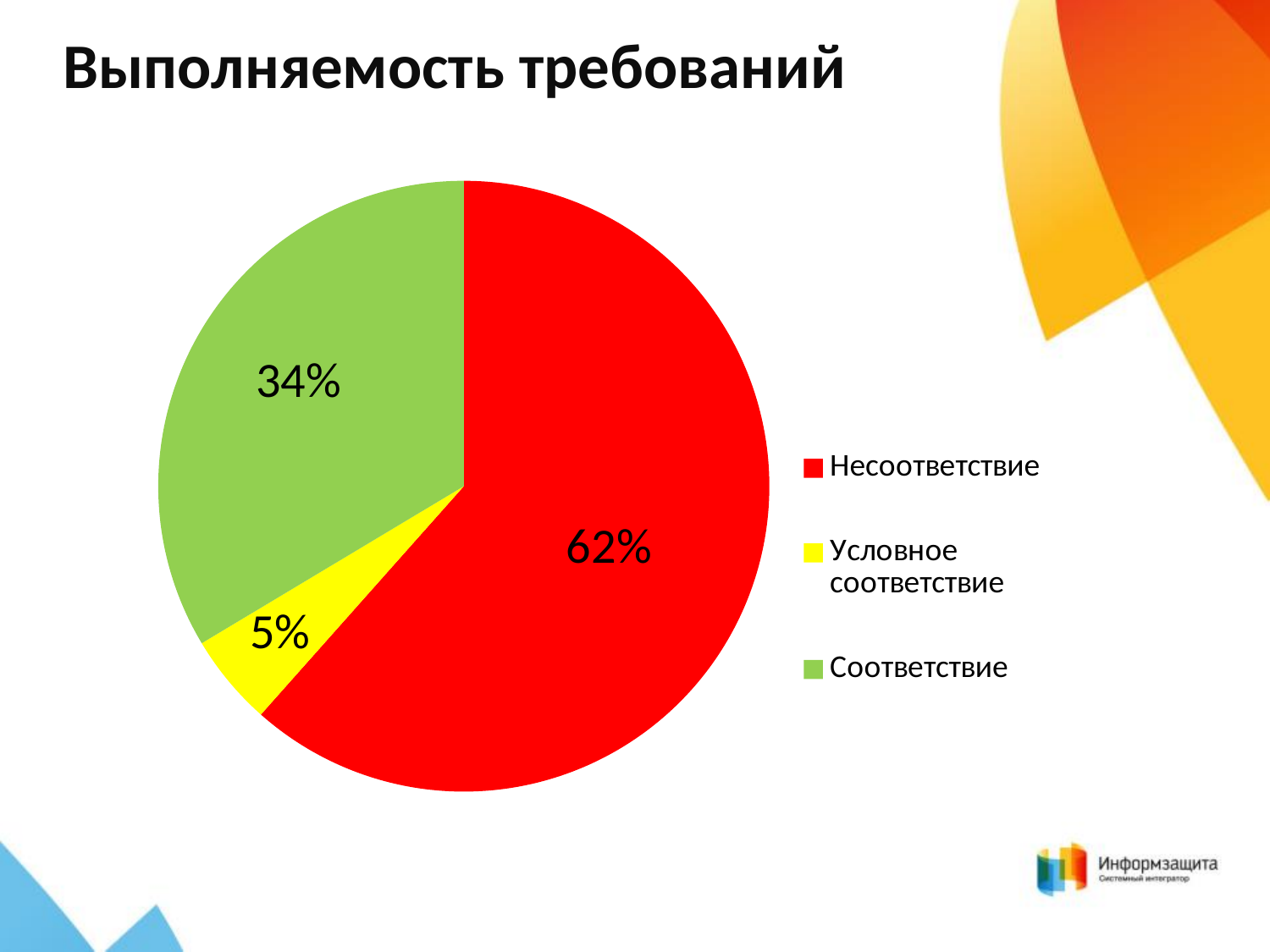
How many entries does the legend list? 3 Which category has the largest slice of the pie? Несоответствие What share of the pie does Несоответствие take? 62% What is the difference in percentage points between Несоответствие and Соответствие? 28 What share of the pie does Соответствие take? 34% What share of the pie does Условное соответствие take? 5% What colour is the slice for Условное соответствие? yellow What is the title of the slide containing the chart? Выполняемость требований Which is larger, the slice for Соответствие or the slice for Условное соответствие? Соответствие What kind of chart is shown on the slide? pie chart How many slices does the pie chart have? 3 Which category has the smallest slice of the pie? Условное соответствие